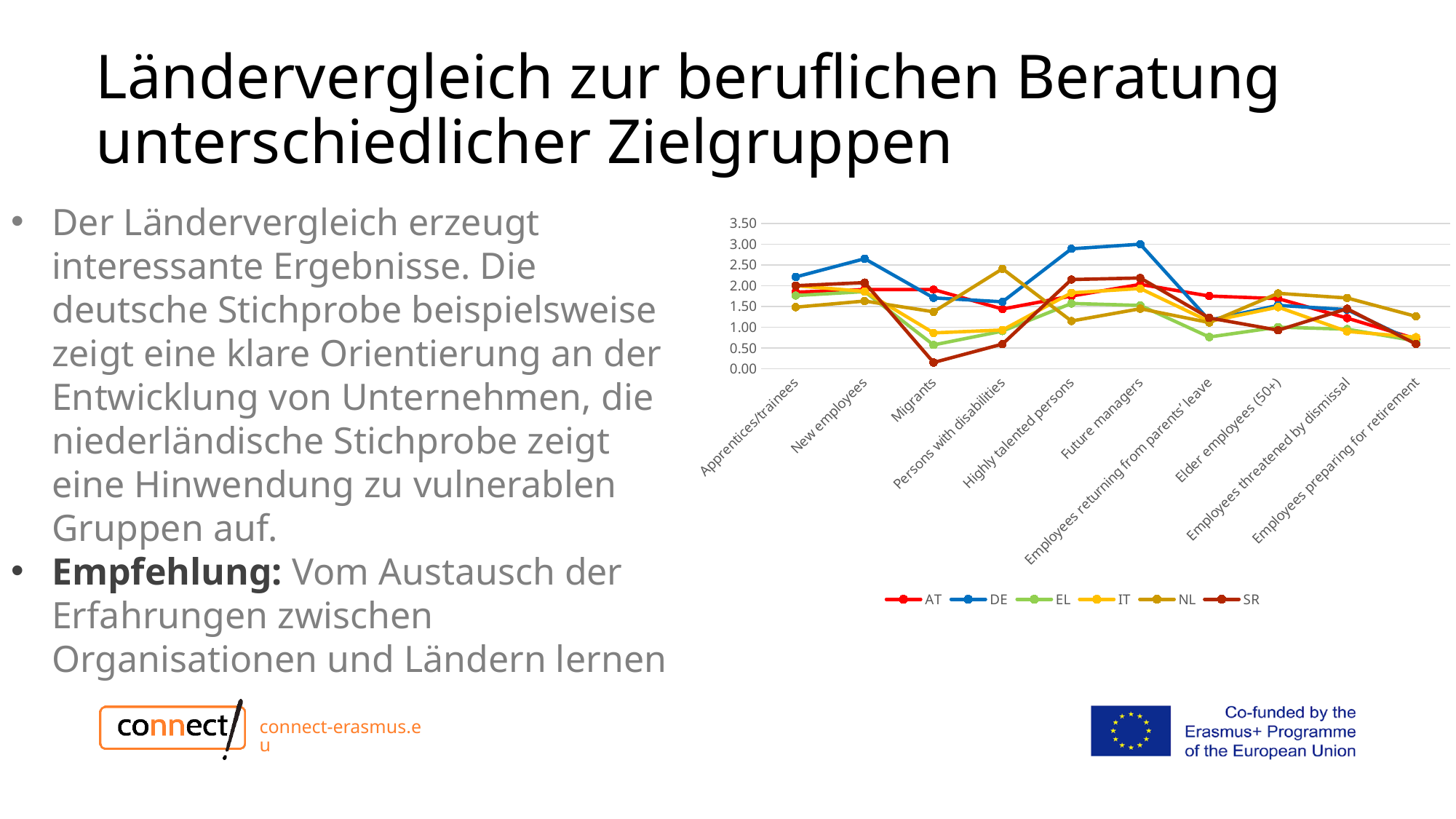
Does the DE series rise or fall from Persons with disabilities to Future managers? rise Is the value for SR at Migrants greater or less than 0.50? less How many series does the chart legend list? 6 Which country series has the lowest value for Migrants? SR How many target-group categories are shown along the x axis of the chart? 10 For Migrants, which is larger: the value for DE or the value for SR? DE Which country series has the highest value for Persons with disabilities? NL Is the value for EL at Employees returning from parents' leave greater or less than 1.00? less Which country series has the highest value for Future managers? DE Which colour is used for the DE series in the chart? blue What kind of chart is shown on the slide? line chart Is the value for DE at Highly talented persons greater or less than 2.50? greater